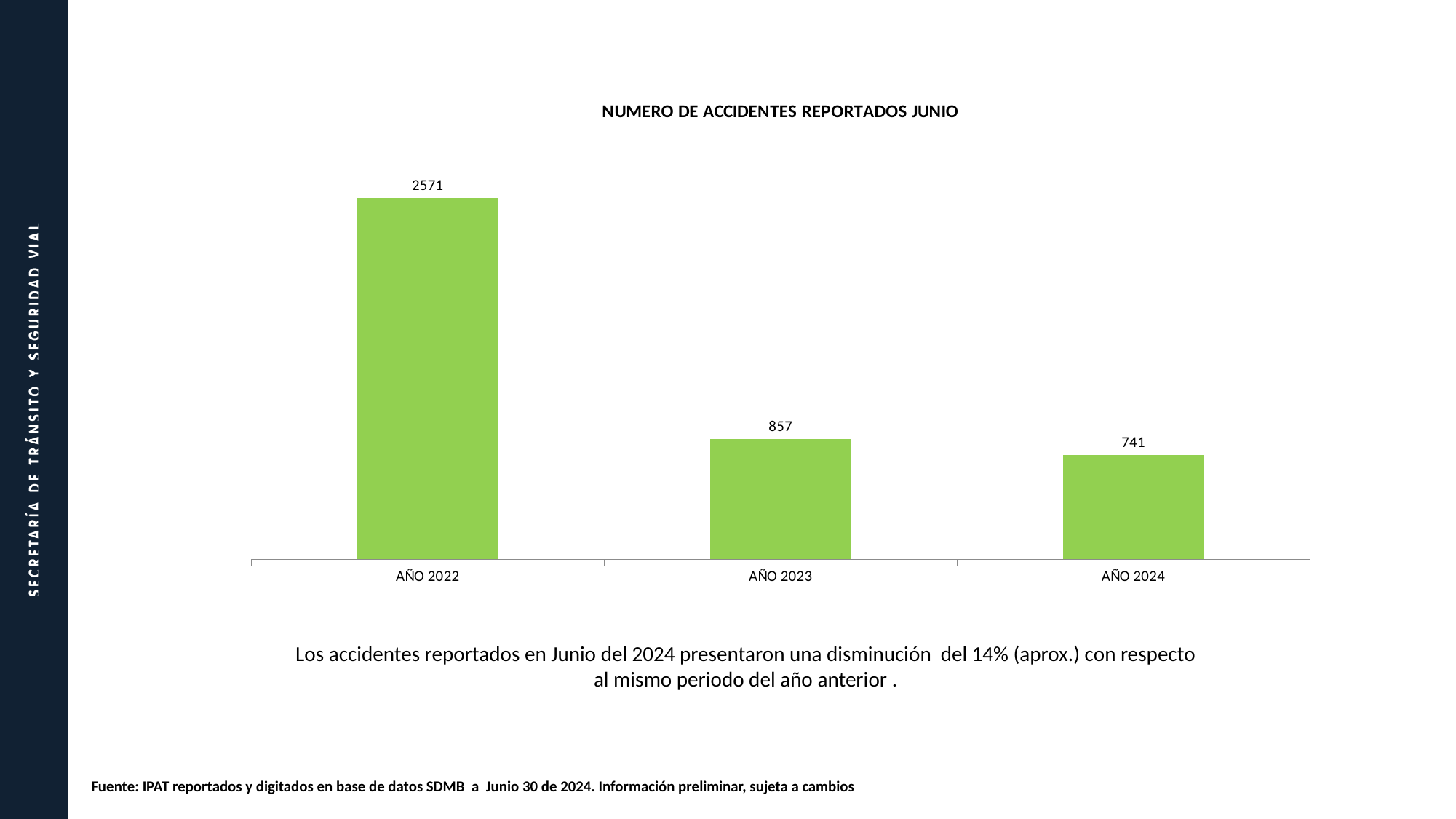
What is the difference between the values for AÑO 2023 and AÑO 2024? 116 Which year has the lowest number of reported accidents? AÑO 2024 Do the values rise or fall from AÑO 2022 to AÑO 2024? Fall Which is larger, the value for AÑO 2023 or AÑO 2024? AÑO 2023 What is the difference between the values for AÑO 2022 and AÑO 2023? 1714 What is the title of the chart? NUMERO DE ACCIDENTES REPORTADOS JUNIO What is the value for AÑO 2022? 2571 What kind of chart is shown on the slide? Bar chart What is the value for AÑO 2023? 857 How many categories are shown on the x axis? 3 What is the value for AÑO 2024? 741 Which year has the highest number of reported accidents? AÑO 2022